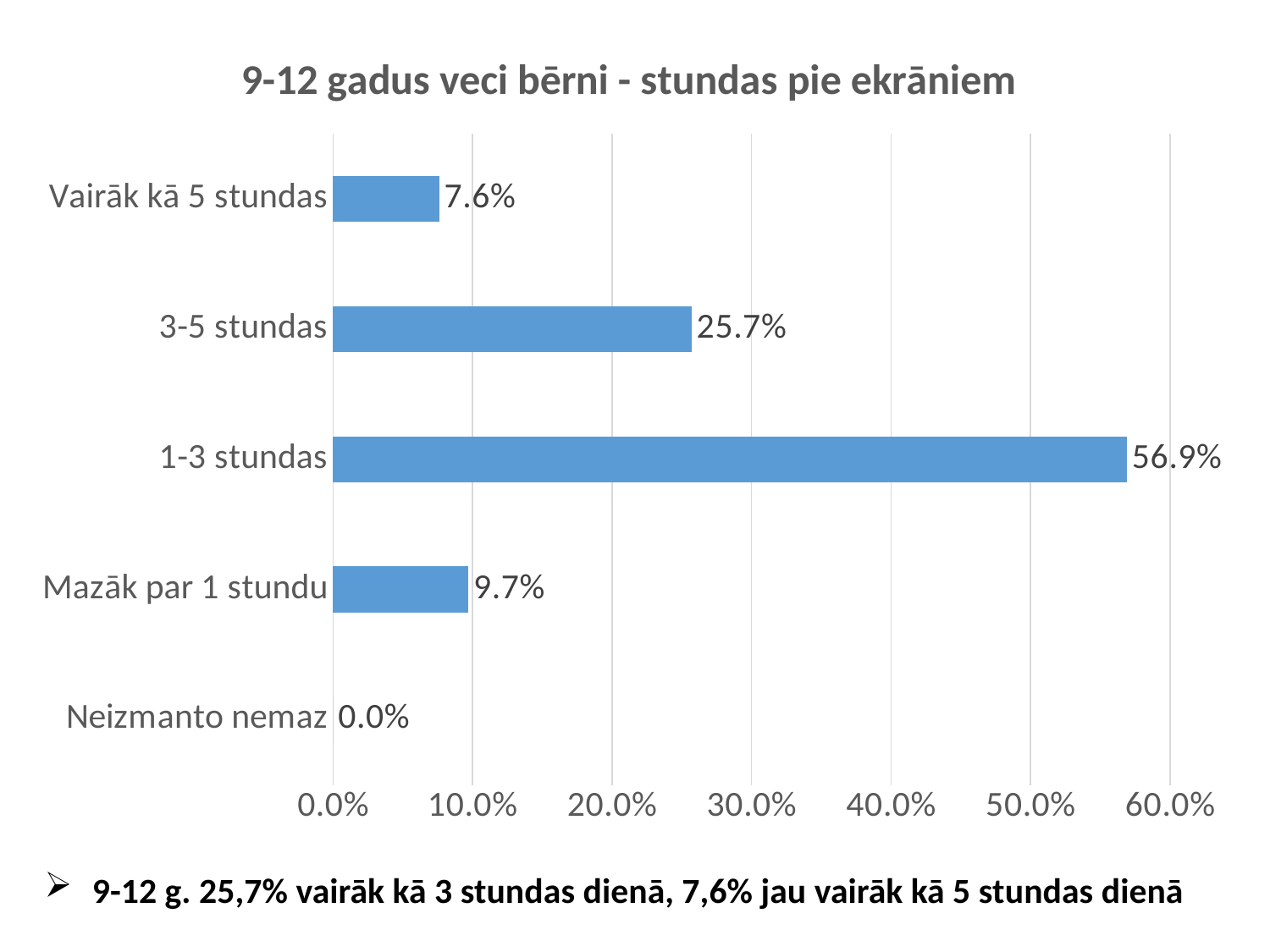
What is the title of the chart? 9-12 gadus veci bērni - stundas pie ekrāniem What is the value for "Mazāk par 1 stundu"? 9.7% Which category has the highest value? 1-3 stundas Is the value for "3-5 stundas" greater or less than 20.0%? greater What is the value for "1-3 stundas"? 56.9% What is the value for "Vairāk kā 5 stundas"? 7.6% What is the value for "Neizmanto nemaz"? 0.0% Which is larger, the value for "Mazāk par 1 stundu" or the value for "Vairāk kā 5 stundas"? Mazāk par 1 stundu What kind of chart is shown on the slide? bar chart Which category has the lowest value? Neizmanto nemaz How many categories are shown on the chart? 5 What is the difference between the values for "1-3 stundas" and "3-5 stundas"? 31.2%